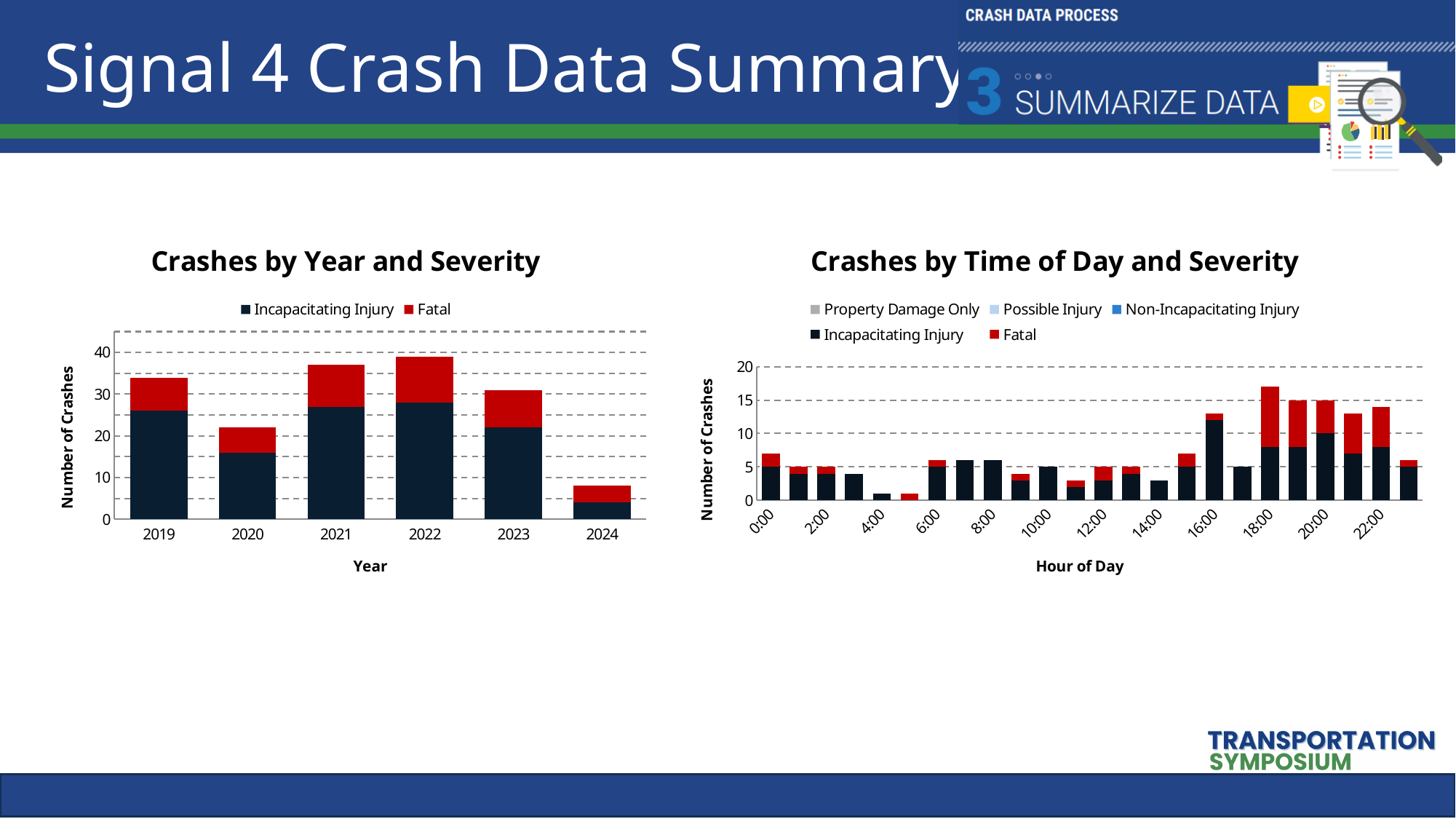
In the 'Crashes by Year and Severity' chart, which year has the lowest total number of crashes? 2024 In the 'Crashes by Year and Severity' chart, how many years are shown on the x axis? 6 In the 'Crashes by Year and Severity' chart, which is larger, the total crashes in 2021 or in 2020? 2021 In the 'Crashes by Time of Day and Severity' chart, which hour of day has the highest total number of crashes? 18:00 What kind of chart is 'Crashes by Year and Severity'? Stacked bar chart In the 'Crashes by Time of Day and Severity' chart, how many series does the legend list? 5 In the 'Crashes by Year and Severity' chart, how many series does the legend list? 2 In the 'Crashes by Year and Severity' chart, is the total number of crashes for 2024 greater or less than 10? less In the 'Crashes by Time of Day and Severity' chart, is the total number of crashes at 18:00 greater or less than 15? greater In the 'Crashes by Year and Severity' chart, is the total number of crashes for 2019 greater or less than 30? greater In the 'Crashes by Time of Day and Severity' chart, what colour represents Fatal crashes? Red In the 'Crashes by Year and Severity' chart, do total crashes rise or fall from 2022 to 2024? Fall